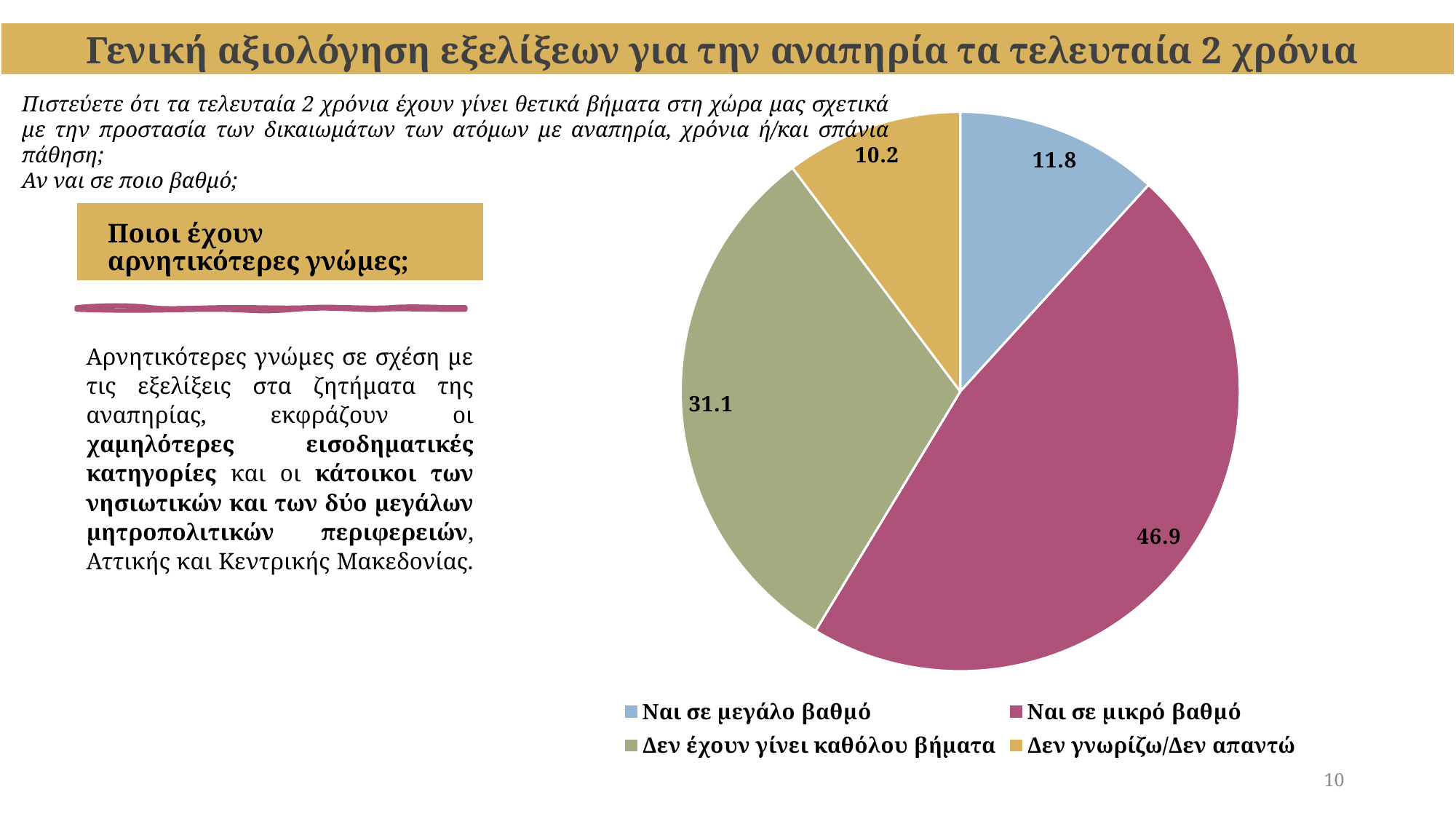
Which category has the smallest slice of the pie? Δεν γνωρίζω/Δεν απαντώ Which category has the largest slice of the pie? Ναι σε μικρό βαθμό What kind of chart is shown on the slide? Pie chart What is the value for "Ναι σε μικρό βαθμό"? 46.9 What is the value for "Δεν έχουν γίνει καθόλου βήματα"? 31.1 What is the difference between the values for "Ναι σε μικρό βαθμό" and "Δεν έχουν γίνει καθόλου βήματα"? 15.8 How many slices does the pie chart have? 4 What colour is the slice for "Δεν έχουν γίνει καθόλου βήματα"? Green What is the value for "Ναι σε μεγάλο βαθμό"? 11.8 What is the value for "Δεν γνωρίζω/Δεν απαντώ"? 10.2 Which is larger, the value for "Ναι σε μεγάλο βαθμό" or the value for "Δεν γνωρίζω/Δεν απαντώ"? Ναι σε μεγάλο βαθμό How many entries does the legend list? 4